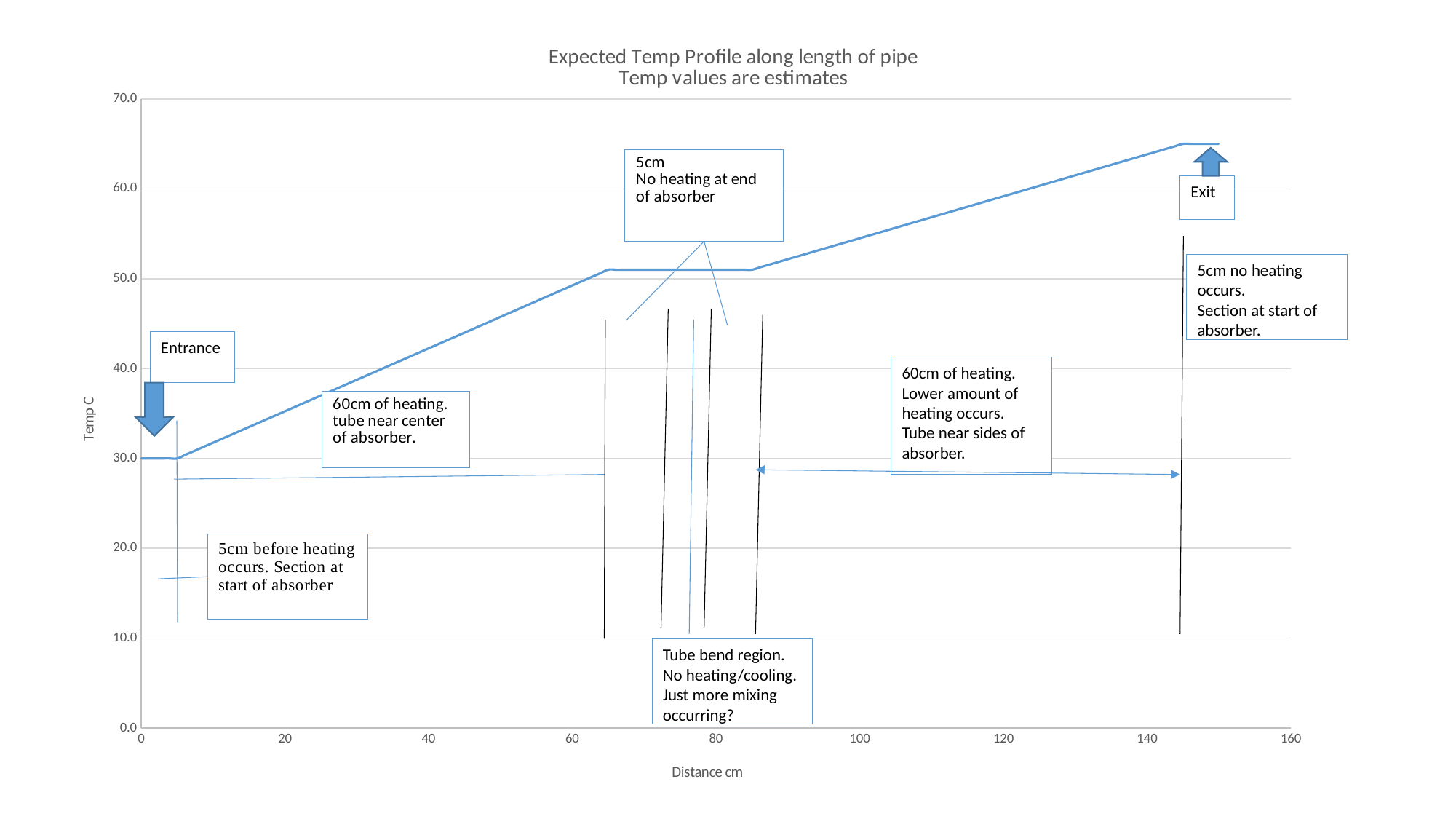
Is the temperature at a distance of 100 cm greater or less than 50? greater What kind of chart is shown on the slide? line chart Overall, does the temperature rise or fall as distance along the pipe increases? rise Is the temperature at the entrance (0 cm) greater or less than 40? less Which is higher, the temperature at 40 cm or the temperature at 140 cm? 140 cm What is the label of the horizontal axis? Distance cm What is the title of the chart? Expected Temp Profile along length of pipe Temp values are estimates Is the temperature at a distance of 20 cm greater or less than 40? less At which end of the pipe, entrance or exit, is the temperature lowest? entrance At which end of the pipe, entrance or exit, is the temperature highest? exit